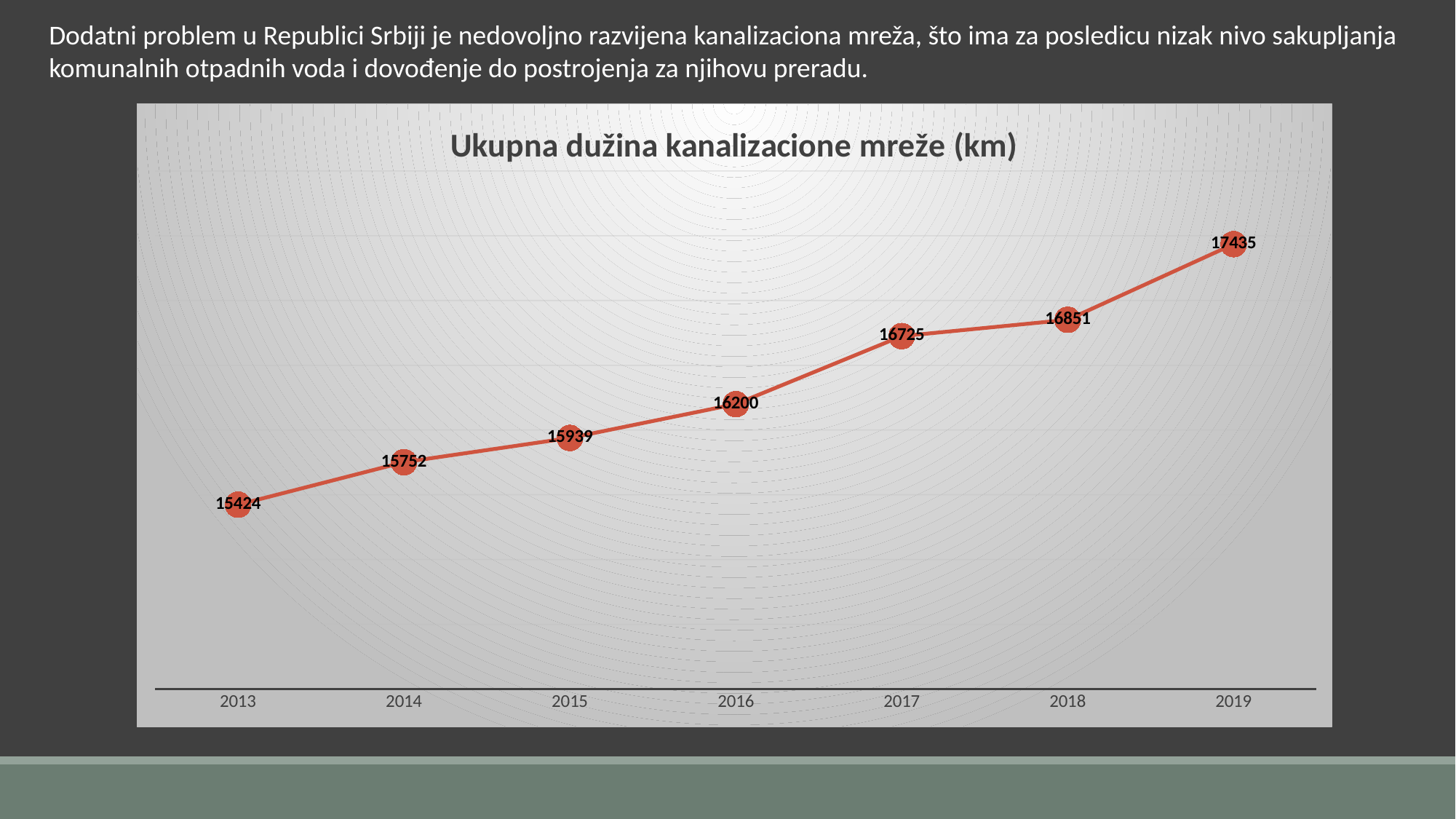
Do the values rise or fall from 2013 to 2019? rise What is the difference between the values for 2017 and 2016? 525 How many years are plotted on the chart? 7 What value is shown for 2016? 16200 What is the total length of the sewerage network in 2013? 15424 What is the difference between the values for 2019 and 2013? 2011 What is the title of the chart? Ukupna dužina kanalizacione mreže (km) What kind of chart is this? line chart Which is larger, the value for 2015 or the value for 2014? 2015 Which year has the lowest value? 2013 What value is shown for 2018? 16851 Which year has the highest value? 2019